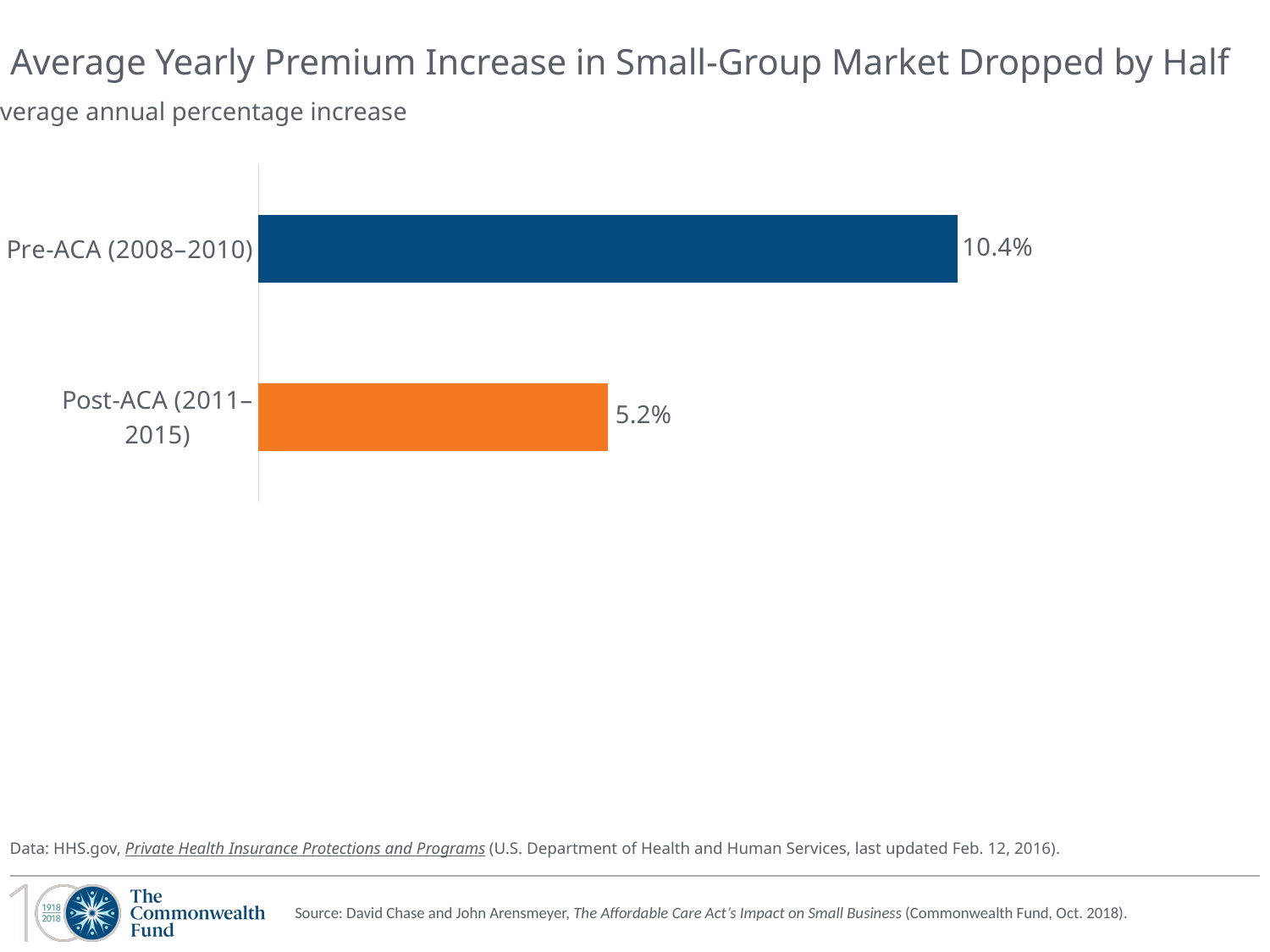
What is the title of the chart? Average Yearly Premium Increase in Small-Group Market Dropped by Half How many categories are shown in the chart? 2 Which period has the higher average annual percentage increase? Pre-ACA (2008–2010) What is the average annual percentage increase for Pre-ACA (2008–2010)? 10.4% Which period has the lower average annual percentage increase? Post-ACA (2011–2015) What colour is the bar for Post-ACA (2011–2015)? orange What is the difference in percentage points between the Pre-ACA and Post-ACA values? 5.2 What kind of chart is shown on the slide? bar chart What is the average annual percentage increase for Post-ACA (2011–2015)? 5.2% Is the value for Pre-ACA (2008–2010) larger or smaller than the value for Post-ACA (2011–2015)? larger